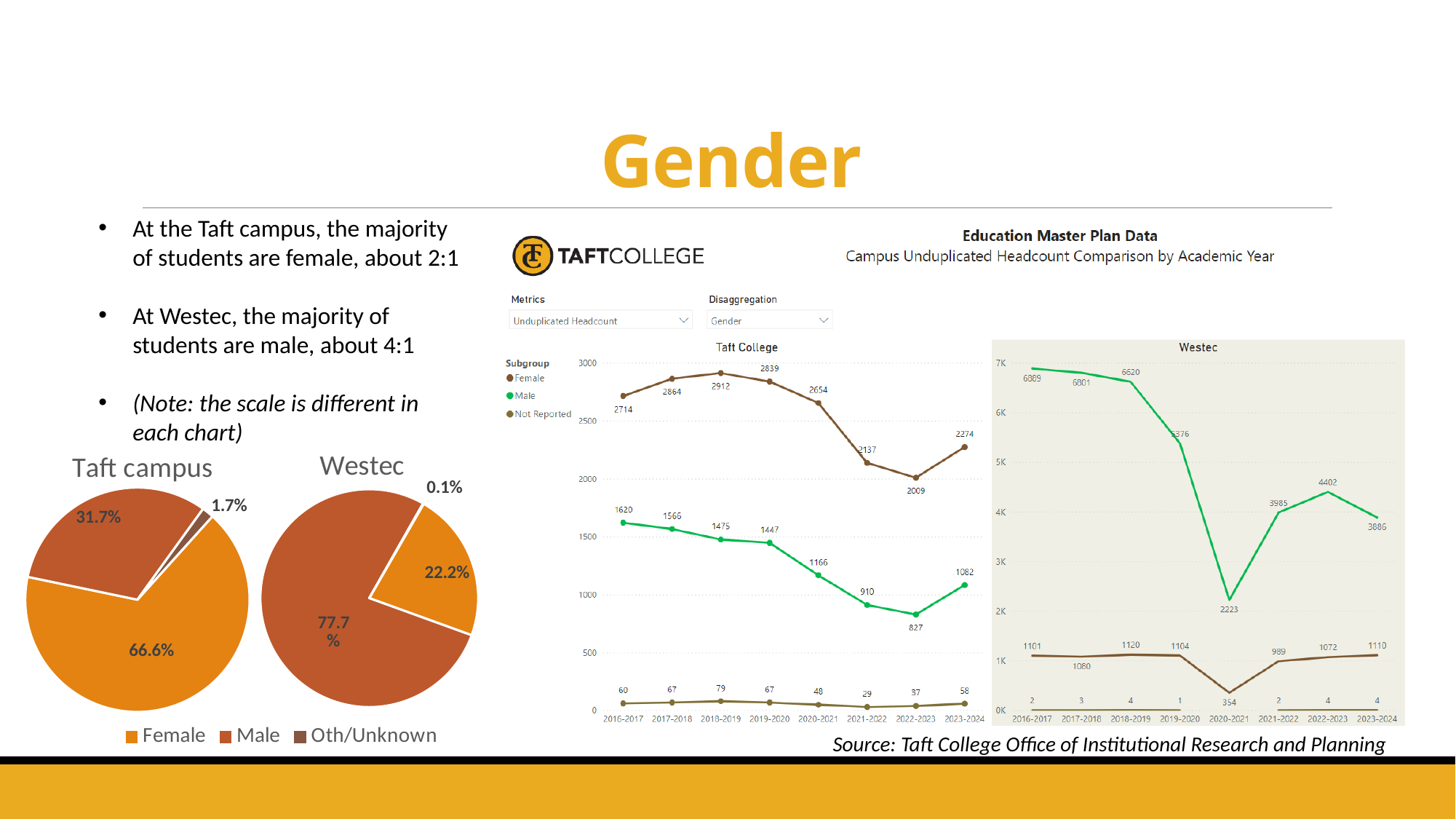
In the Westec pie chart, what share is Oth/Unknown? 0.1% In the Taft College line chart, what is the Male headcount for 2022-2023? 827 In the Taft College line chart, what is the difference between the Female and Male headcounts in 2016-2017? 1094 In the Westec line chart, is the Male headcount for 2022-2023 greater or less than 4K? greater In the Taft campus pie chart, what share of students is female? 66.6% In the Taft College line chart, what is the Female headcount for 2018-2019? 2912 In the Taft College line chart, in which academic year is the Female headcount lowest? 2022-2023 In the Taft campus pie chart, which category has the smallest slice? Oth/Unknown In the Westec line chart, what is the Male headcount for 2020-2021? 2223 In the Westec pie chart, what share of students is male? 77.7% What kind of chart is the Taft College chart on the right side of the slide? Line chart How many categories does the legend of the pie charts list? 3